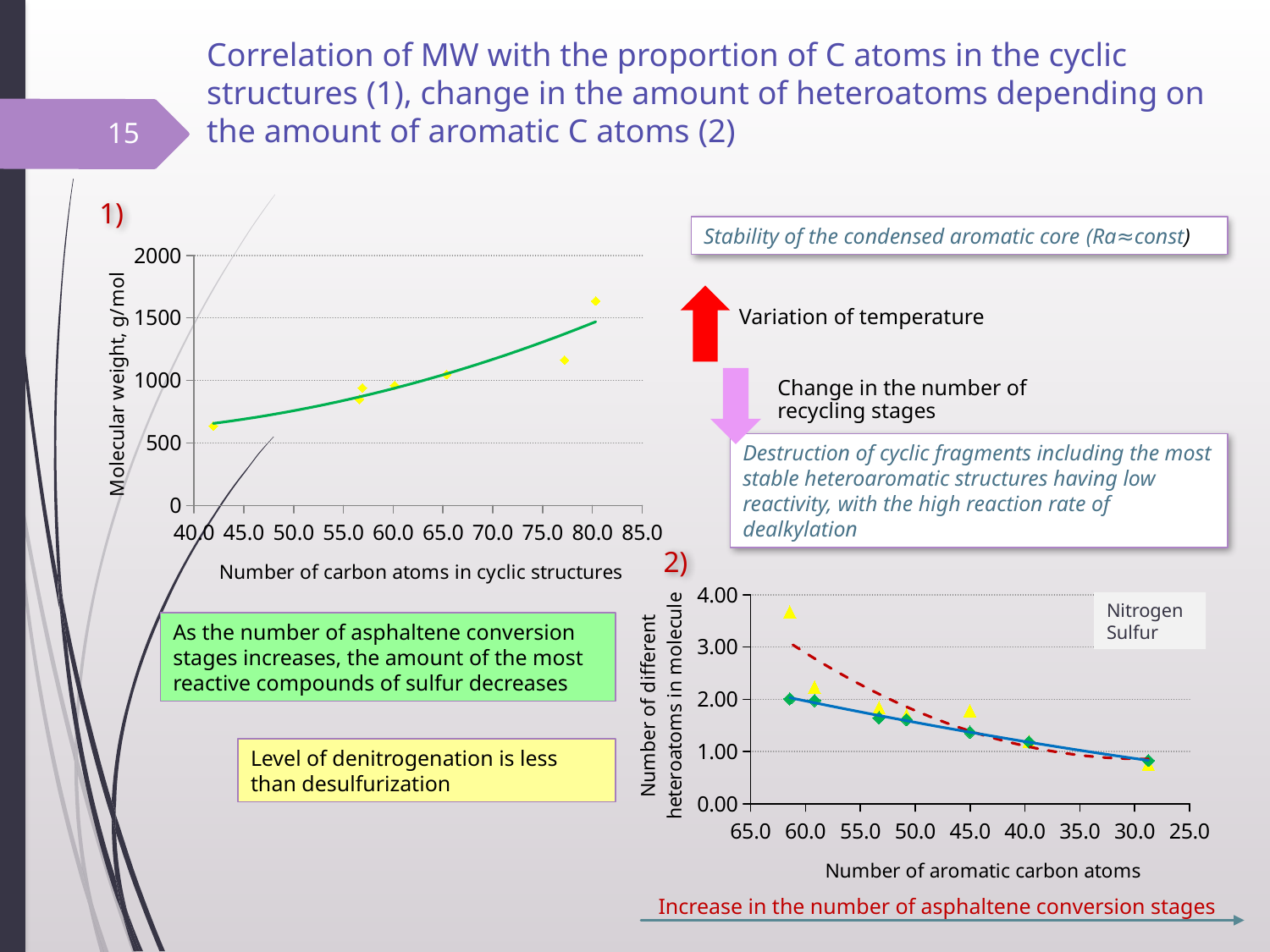
In chart 1, does molecular weight rise or fall as the number of carbon atoms in cyclic structures increases? rise In chart 2, is the Nitrogen value at the rightmost point greater or less than 1.00? less What is the x-axis title of chart 1? Number of carbon atoms in cyclic structures In chart 1, is the molecular weight of the leftmost point greater or less than 1000? less In chart 1, is the molecular weight of the highest point greater or less than 1500? greater In chart 1 (Molecular weight vs number of carbon atoms in cyclic structures), what kind of chart is it? scatter chart In chart 2, do the number of heteroatoms rise or fall moving from left to right along the x axis? fall In chart 2 (Number of different heteroatoms in molecule), how many series does the legend list? 2 In chart 2, at the leftmost data point, which series has the larger value, Nitrogen or Sulfur? Sulfur In chart 2, what are the two series named in the legend? Nitrogen and Sulfur